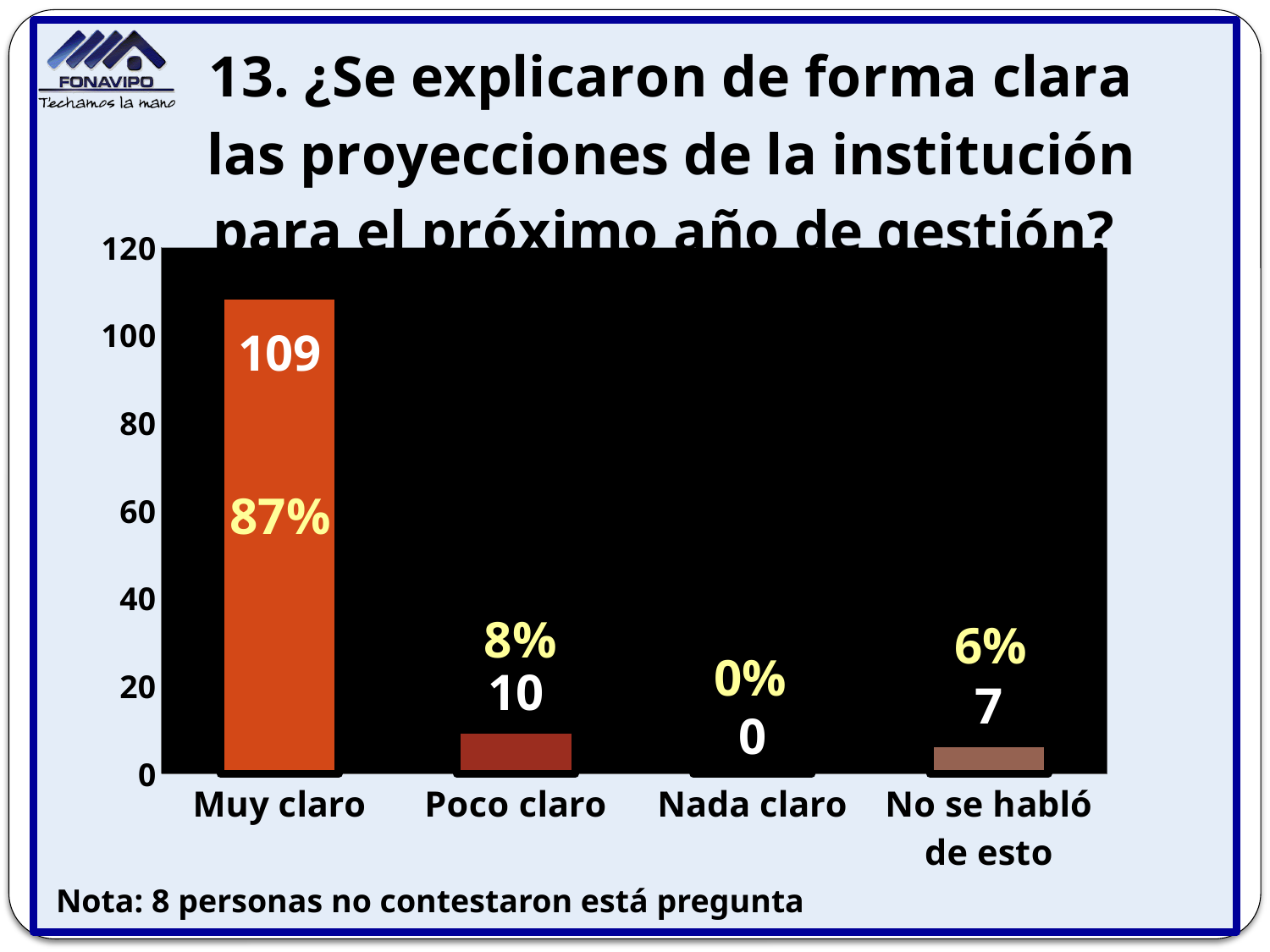
What kind of chart is shown on the slide? bar chart What is the value for "Muy claro"? 109 What is the value for "No se habló de esto"? 7 Which category has the lowest value? Nada claro Which category has the highest value? Muy claro What percentage is shown for "Muy claro"? 87% Is the value for "Muy claro" greater or less than 100? greater How many categories are shown on the x axis? 4 What is the value for "Poco claro"? 10 Which is larger, the value for "Poco claro" or the value for "No se habló de esto"? Poco claro What is the difference between the values for "Muy claro" and "Poco claro"? 99 What percentage is shown for "No se habló de esto"? 6%